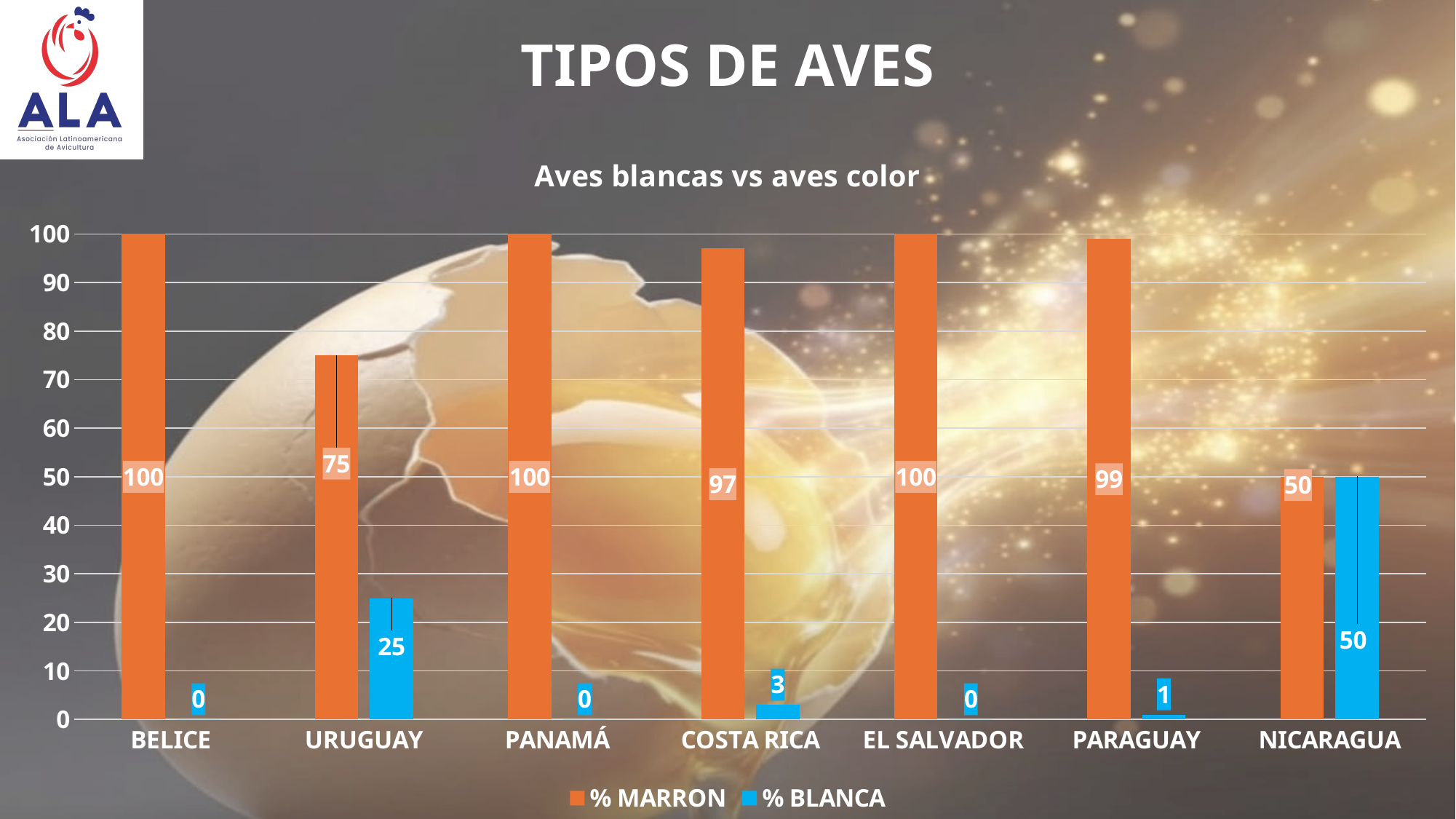
What is the % MARRON value for Paraguay? 99 What is the difference between the % MARRON and % BLANCA values for Uruguay? 50 What is the % BLANCA value for Nicaragua? 50 How many countries are shown on the x axis? 7 What is the title of the chart? Aves blancas vs aves color How many series does the legend list? 2 What is the % BLANCA value for Costa Rica? 3 Which country has the lowest % MARRON value? Nicaragua What is the % MARRON value for Uruguay? 75 Which country has the highest % BLANCA value? Nicaragua Which is larger, the % BLANCA value for Uruguay or the % BLANCA value for Costa Rica? Uruguay What kind of chart is shown on the slide? Bar chart